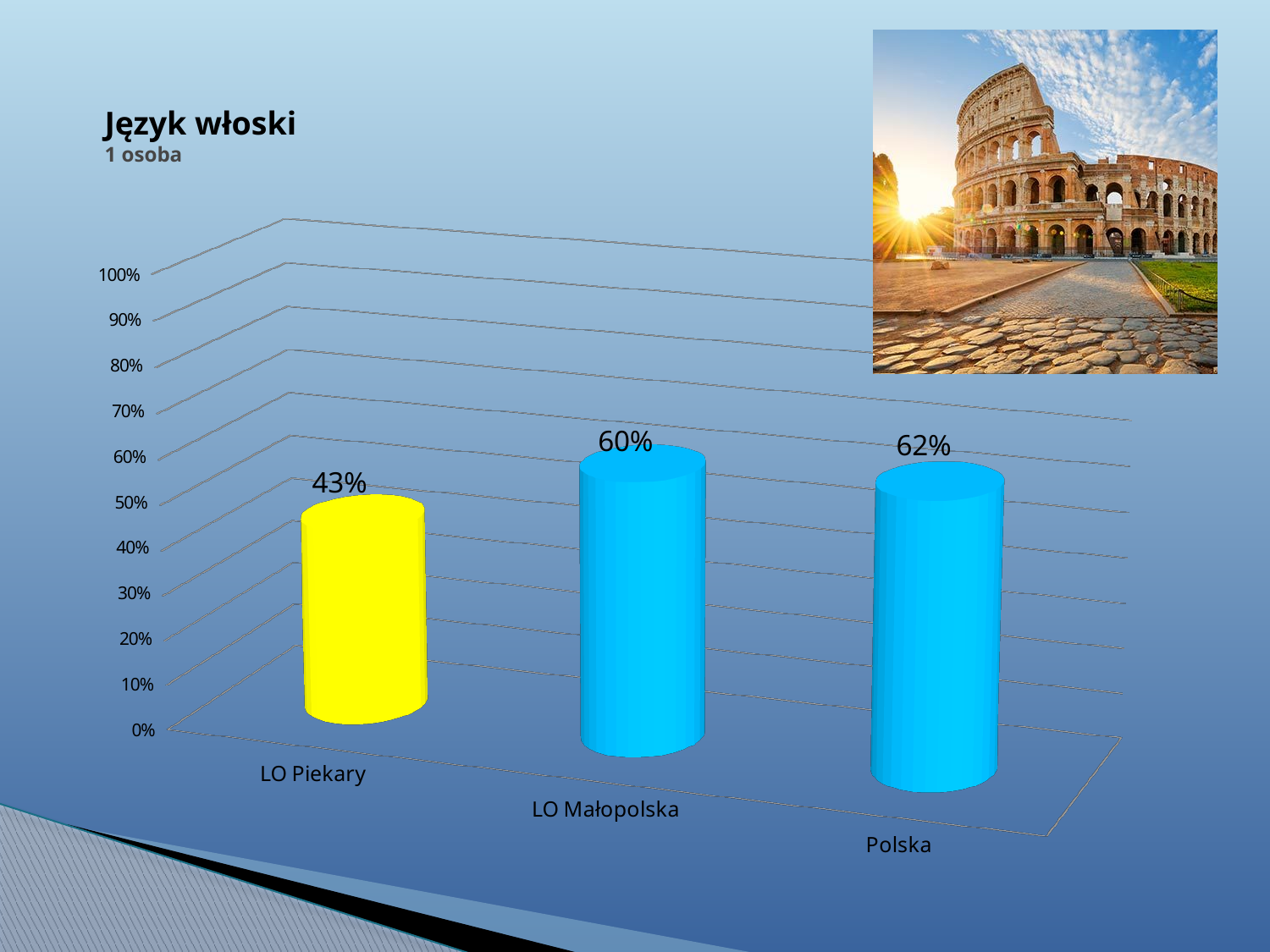
How many categories are shown on the chart? 3 What is the value for Polska? 62% What is the value for LO Małopolska? 60% What is the difference between the values for Polska and LO Piekary? 19% Is the value for LO Piekary greater or less than 50%? less Which is larger, the value for LO Piekary or the value for LO Małopolska? LO Małopolska What colour is the bar for LO Piekary? yellow Which category has the lowest value? LO Piekary Which category has the highest value? Polska What is the difference between the values for LO Małopolska and LO Piekary? 17% What kind of chart is shown on the slide? bar chart What is the value for LO Piekary? 43%